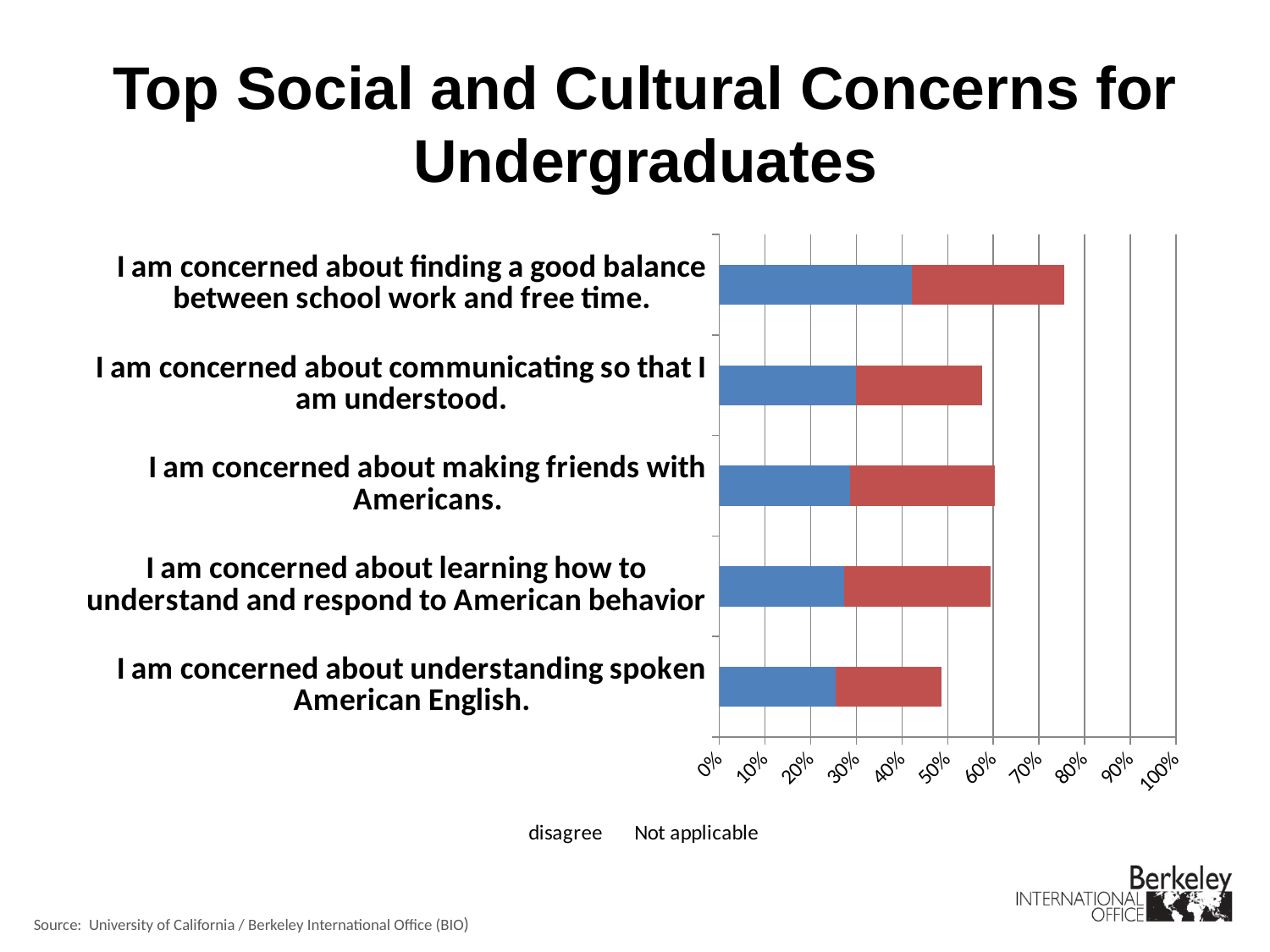
Is the total bar for "I am concerned about finding a good balance between school work and free time." greater or less than 70%? greater What is the title of the slide containing the chart? Top Social and Cultural Concerns for Undergraduates Which concern statement has the longest total bar? I am concerned about finding a good balance between school work and free time. Which has the longer total bar: "I am concerned about finding a good balance between school work and free time." or "I am concerned about understanding spoken American English."? I am concerned about finding a good balance between school work and free time. How many series does the chart legend list? 2 Is the total bar for "I am concerned about communicating so that I am understood." greater or less than 70%? less Is the total bar for "I am concerned about making friends with Americans." greater or less than 50%? greater Which concern statement has the shortest total bar? I am concerned about understanding spoken American English. What kind of chart is shown on the slide? Stacked bar chart How many concern statements (categories) are plotted in the chart? 5 What are the two series named in the legend? disagree and Not applicable